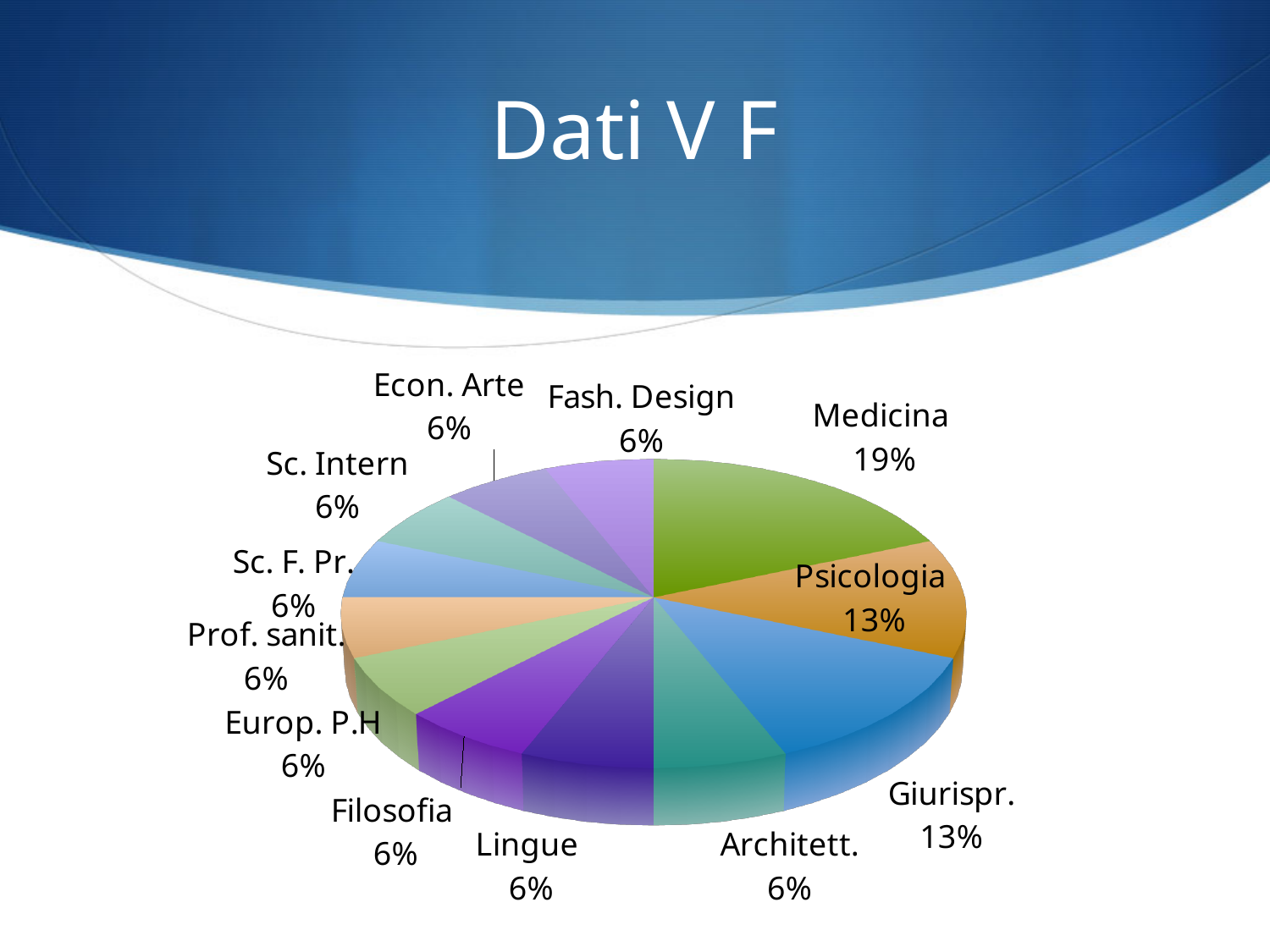
What is the difference between the shares of Medicina and Psicologia? 6% Which has a larger share, Giurispr. or Architett.? Giurispr. What share of the pie does Filosofia have? 6% What share of the pie does Giurispr. have? 13% What is the title of the chart? Dati V F What share of the pie does Psicologia have? 13% What share of the pie does Fash. Design have? 6% Which category has the largest share of the pie? Medicina What is the difference between the shares of Giurispr. and Lingue? 7% What kind of chart is shown on the slide? pie chart How many categories are shown in the pie chart? 12 What share of the pie does Medicina have? 19%